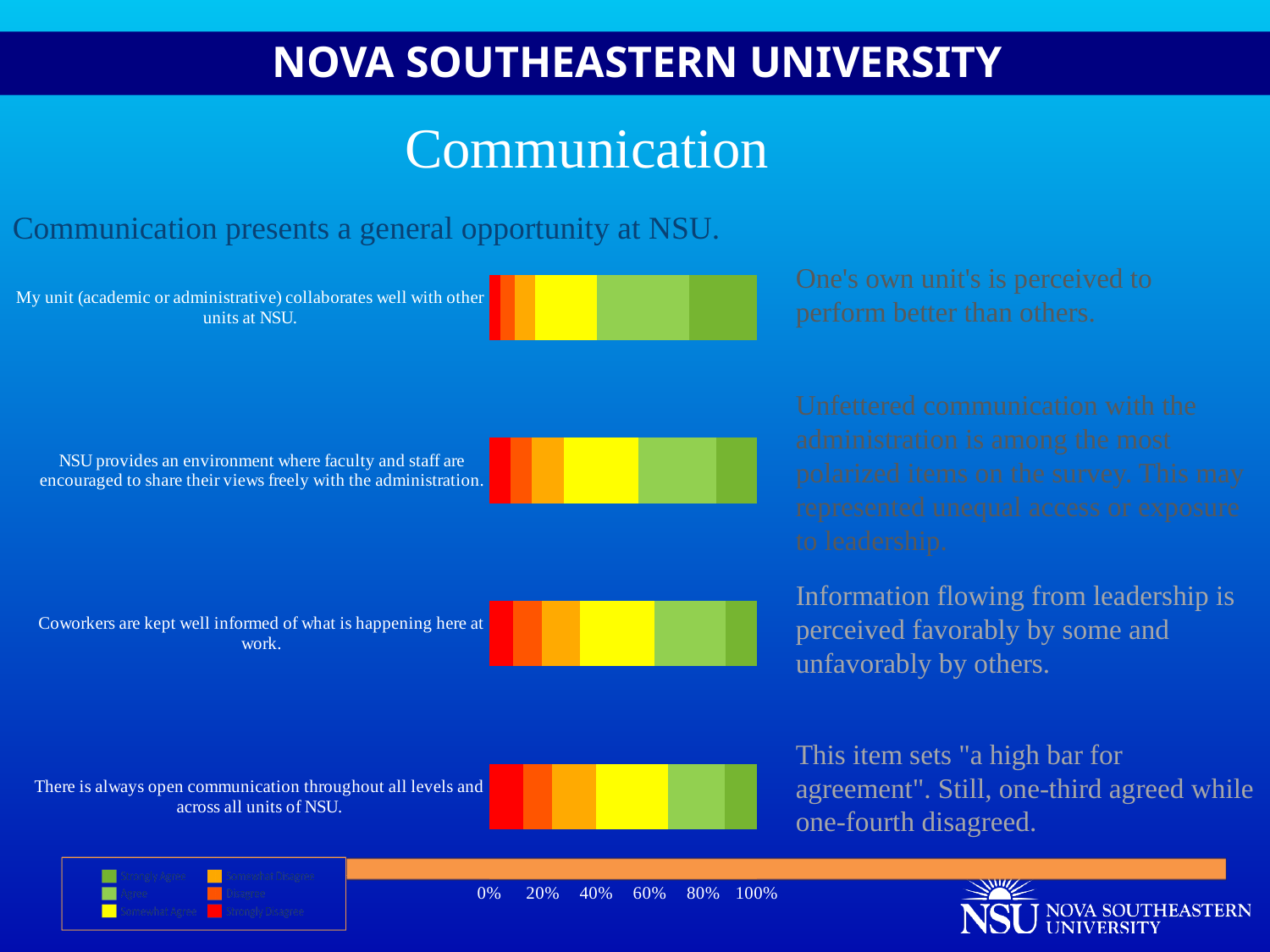
Which colour represents 'Strongly Disagree' in the chart's legend? Red Is the 'Strongly Disagree' segment larger for 'My unit (academic or administrative) collaborates well with other units at NSU.' or for 'There is always open communication throughout all levels and across all units of NSU.'? There is always open communication throughout all levels and across all units of NSU. Is the 'Strongly Agree' segment larger for 'My unit (academic or administrative) collaborates well with other units at NSU.' or for 'There is always open communication throughout all levels and across all units of NSU.'? My unit (academic or administrative) collaborates well with other units at NSU. What is the highest value shown on the chart's percentage axis? 100% Which survey item has the largest 'Strongly Agree' segment? My unit (academic or administrative) collaborates well with other units at NSU. How many survey items (bars) are plotted in the chart? 4 How many response categories does the chart's legend list? 6 What kind of chart is shown on the slide? Stacked bar chart